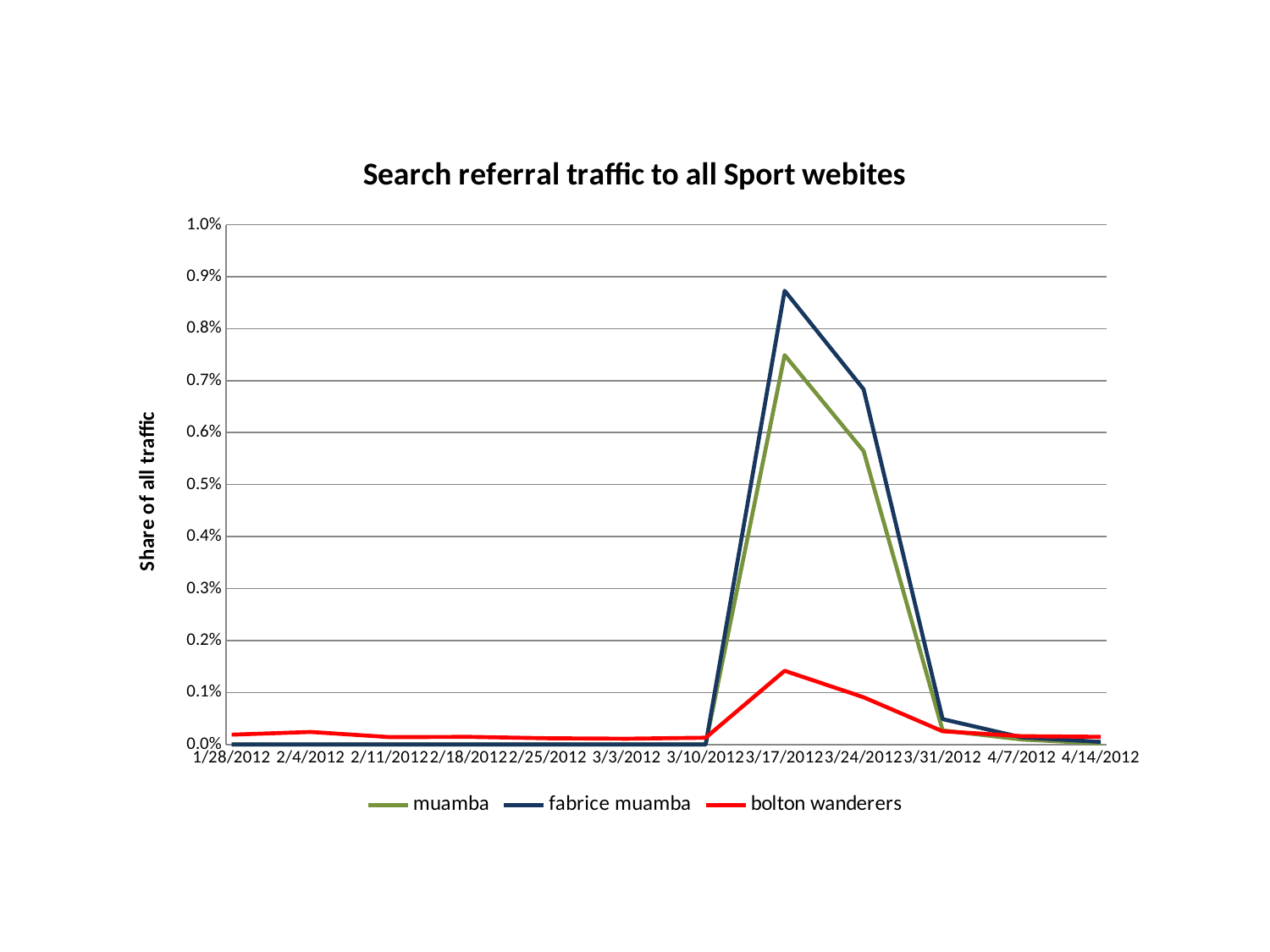
Do the values for fabrice muamba rise or fall between 3/17/2012 and 3/31/2012? fall Is the value for muamba on 3/17/2012 greater or less than 0.7%? greater Is the value for fabrice muamba on 3/17/2012 greater or less than 0.8%? greater On which date does the muamba series reach its highest value? 3/17/2012 Is the value for bolton wanderers on 3/17/2012 greater or less than 0.2%? less On which date does the fabrice muamba series reach its highest value? 3/17/2012 What is the label on the y axis? Share of all traffic How many series does the legend list? 3 What kind of chart is shown on the slide? line chart How many dates are shown along the x axis? 12 On 3/17/2012, which series has the larger value, fabrice muamba or muamba? fabrice muamba What is the title of the chart? Search referral traffic to all Sport webites